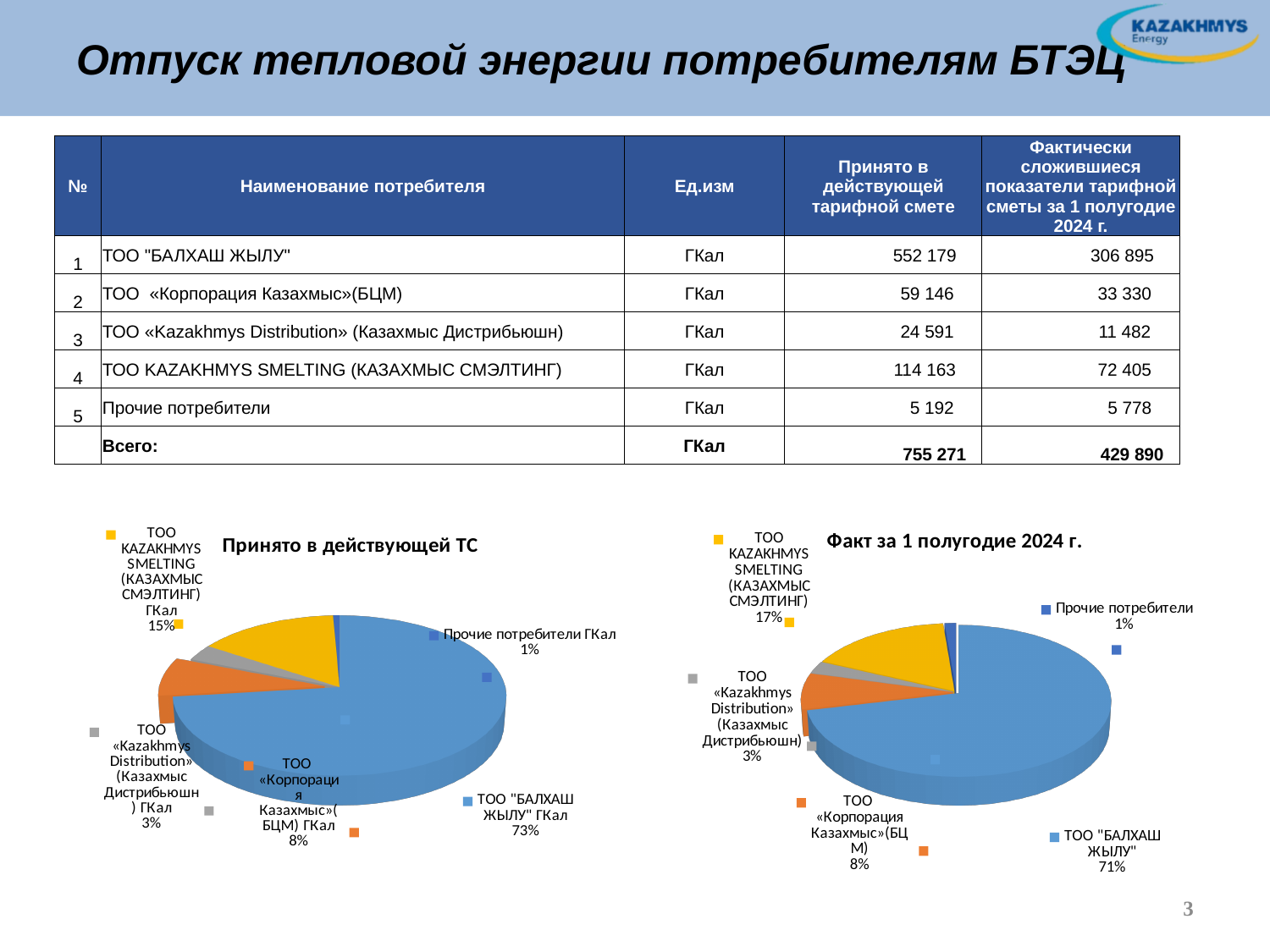
In the "Факт за 1 полугодие 2024 г." pie chart, what share does ТОО "БАЛХАШ ЖЫЛУ" have? 71% In the "Факт за 1 полугодие 2024 г." pie chart, what share does ТОО KAZAKHMYS SMELTING (КАЗАХМЫС СМЭЛТИНГ) have? 17% In the "Принято в действующей ТС" pie chart, what share does ТОО "БАЛХАШ ЖЫЛУ" have? 73% In the "Принято в действующей ТС" pie chart, which has the larger share: ТОО «Корпорация Казахмыс»(БЦМ) or ТОО «Kazakhmys Distribution» (Казахмыс Дистрибьюшн)? ТОО «Корпорация Казахмыс»(БЦМ) What type of chart is used for "Принято в действующей ТС"? pie chart In the "Принято в действующей ТС" pie chart, which category has the largest share? ТОО "БАЛХАШ ЖЫЛУ" ГКал In the "Факт за 1 полугодие 2024 г." pie chart, what is the difference in share between ТОО "БАЛХАШ ЖЫЛУ" and ТОО KAZAKHMYS SMELTING (КАЗАХМЫС СМЭЛТИНГ)? 54% In the "Факт за 1 полугодие 2024 г." pie chart, which category has the smallest share? Прочие потребители How many slices does the "Факт за 1 полугодие 2024 г." pie chart have? 5